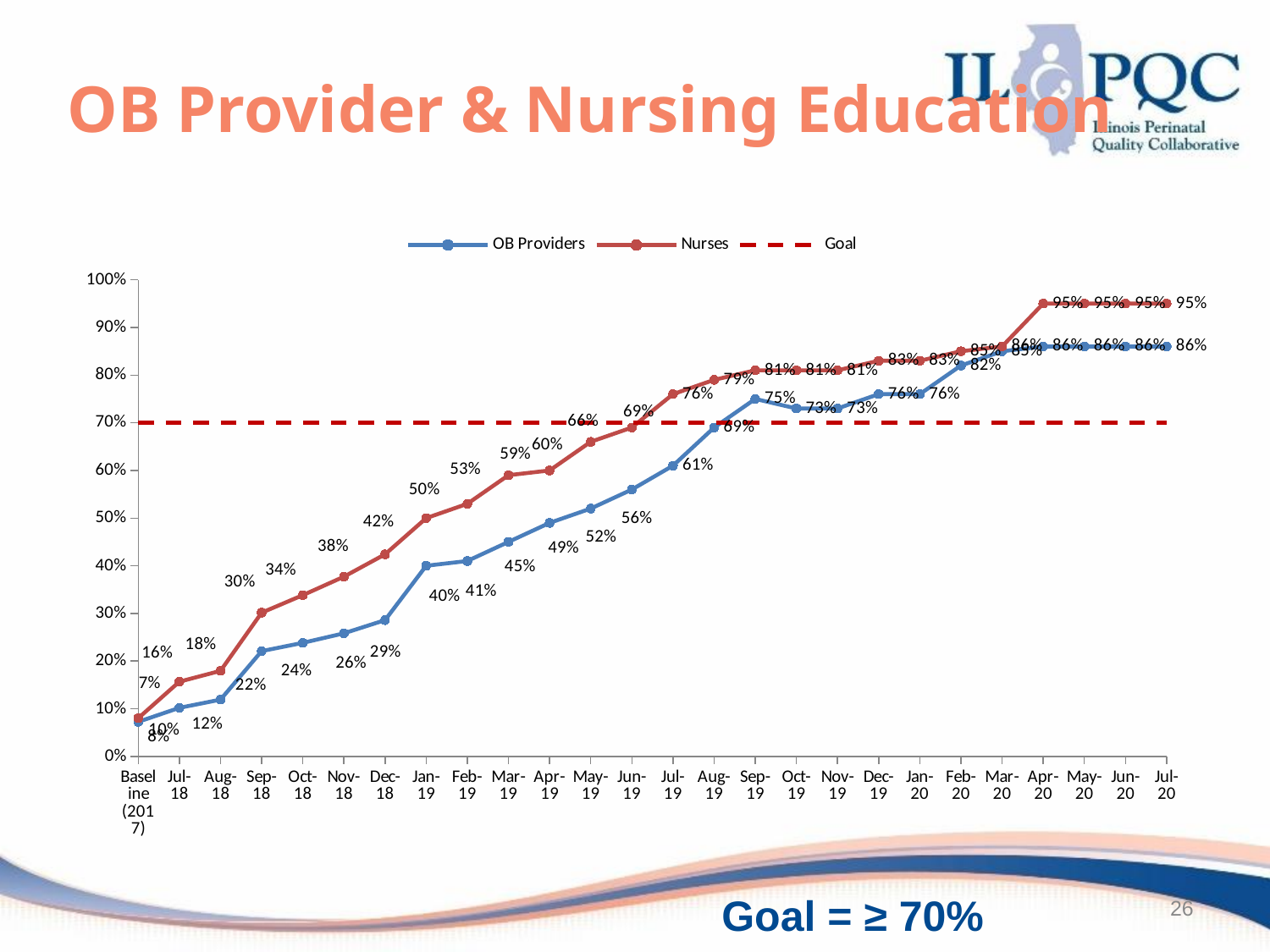
What type of chart is shown on the slide? Line chart What is the difference between the Nurses and OB Providers values in Dec-18? 13 percentage points What is the value for Nurses in Jul-20? 95% What is the value for OB Providers in Dec-18? 29% What is the highest value reached by the Nurses series? 95% At which category is the OB Providers series lowest? Baseline (2017) What is the value for Nurses in Jan-19? 50% At what percentage is the dashed Goal line drawn? 70% How many series does the legend list? 3 In Sep-19, which series has the larger value, OB Providers or Nurses? Nurses What is the value for OB Providers in Jul-19? 61% Do the OB Providers values generally rise or fall from Baseline to Jul-20? Rise